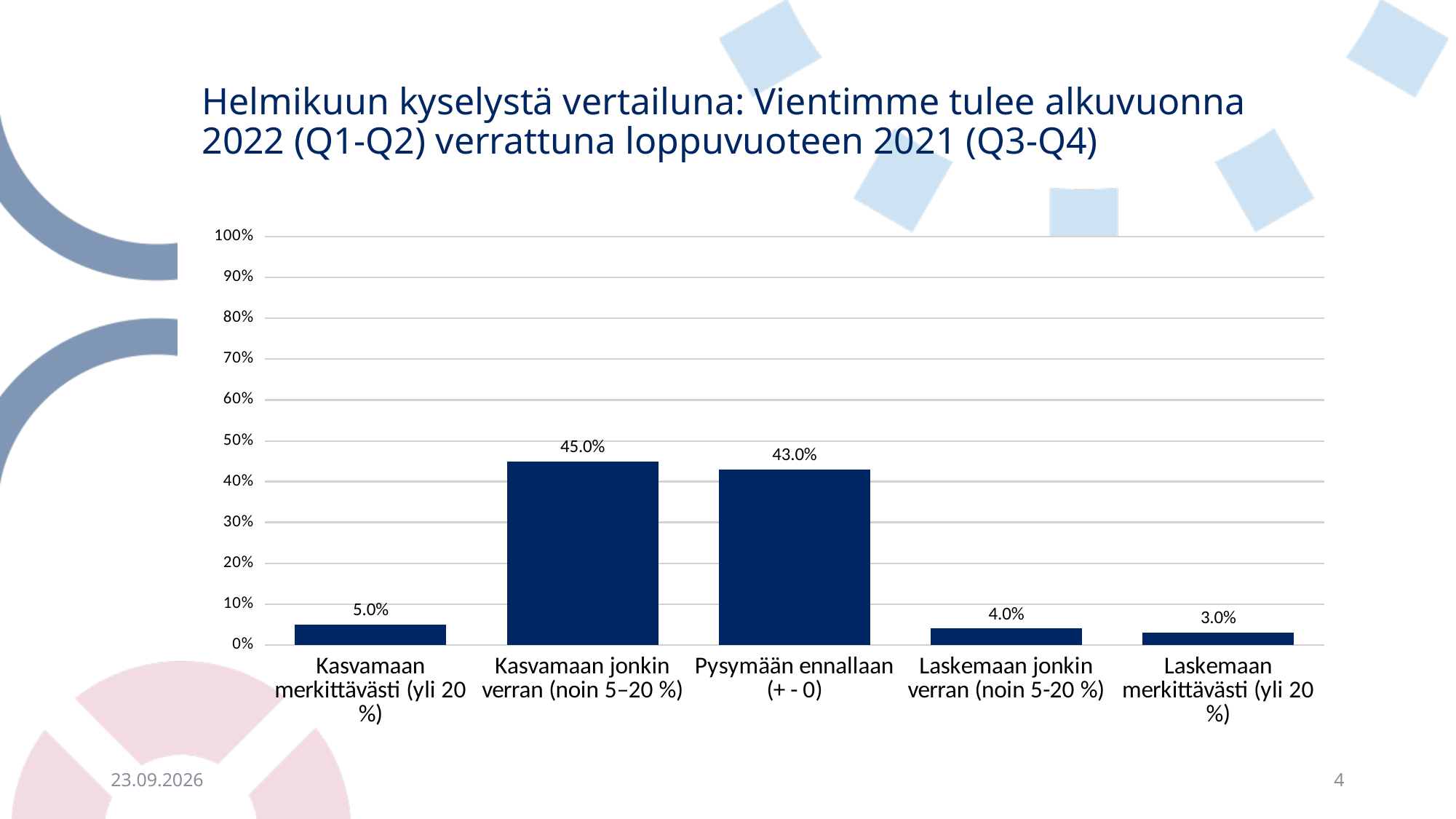
Is the value for "Pysymään ennallaan (+ - 0)" greater or less than 40%? greater What is the value for "Kasvamaan merkittävästi (yli 20 %)"? 5.0% Which category has the lowest value? Laskemaan merkittävästi (yli 20 %) What is the value for "Pysymään ennallaan (+ - 0)"? 43.0% What is the difference between the values for "Kasvamaan jonkin verran (noin 5–20 %)" and "Pysymään ennallaan (+ - 0)"? 2.0% What kind of chart is shown on the slide? bar chart Which is larger: the value for "Kasvamaan merkittävästi (yli 20 %)" or for "Laskemaan jonkin verran (noin 5-20 %)"? Kasvamaan merkittävästi (yli 20 %) What is the value for "Kasvamaan jonkin verran (noin 5–20 %)"? 45.0% Which category has the highest value? Kasvamaan jonkin verran (noin 5–20 %) How many categories are shown on the x axis? 5 What is the value for "Laskemaan merkittävästi (yli 20 %)"? 3.0% What is the highest value shown on the y axis? 100%